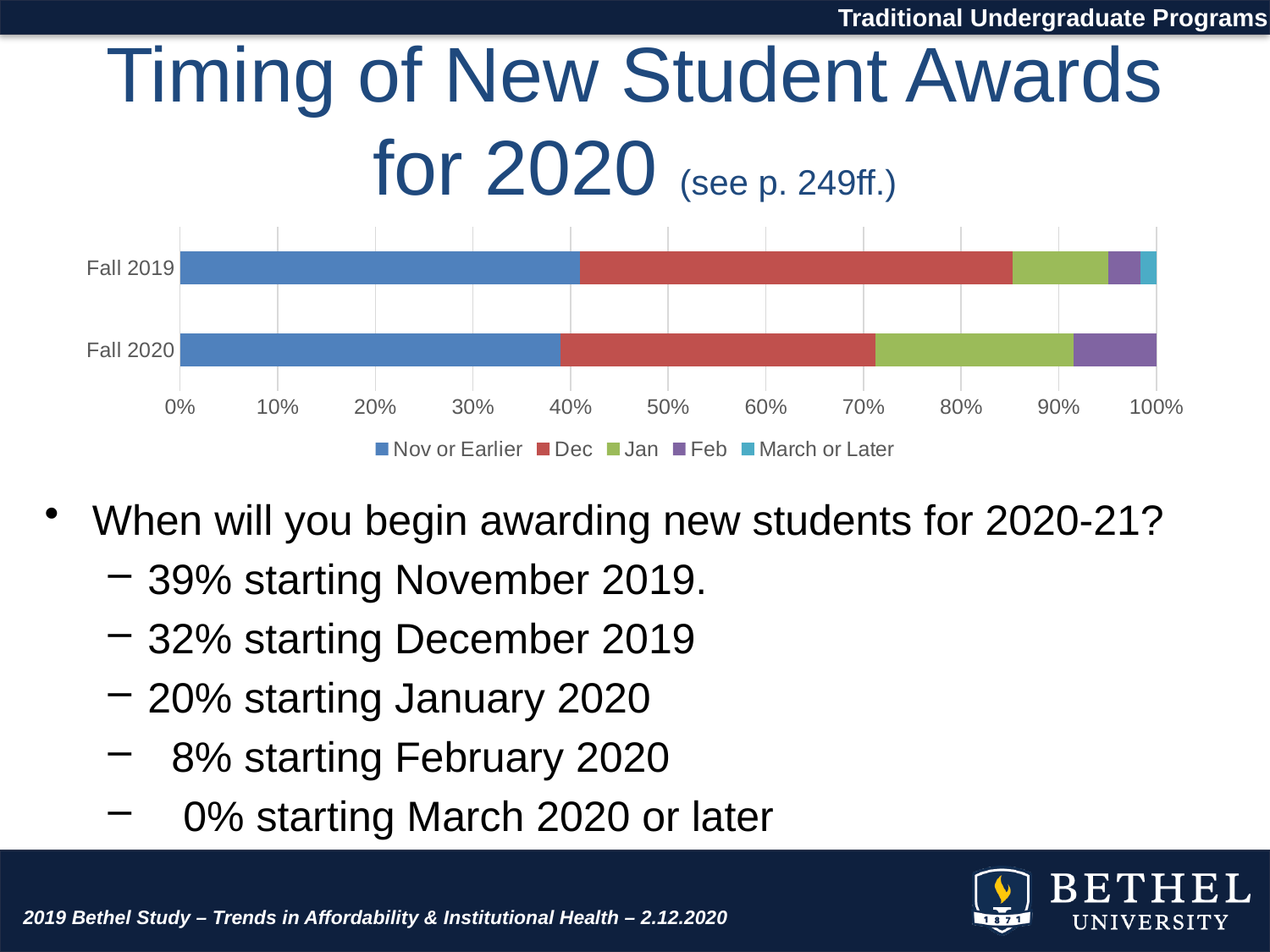
Which bar has the larger 'Jan' segment, Fall 2019 or Fall 2020? Fall 2020 What percentage of the Fall 2020 bar is 'Dec'? 32% What percentage of the Fall 2020 bar is 'March or Later'? 0% How many series does the chart legend list? 5 Which series has the largest segment in the Fall 2020 bar? Nov or Earlier Is the 'Nov or Earlier' segment for Fall 2019 greater or less than 50%? less What percentage of the Fall 2020 bar is 'Jan'? 20% What colour represents 'Dec' in the chart? red Is the 'March or Later' segment for Fall 2019 greater or less than 10%? less What percentage of the Fall 2020 bar is 'Nov or Earlier'? 39% How many categories (bars) does the chart show? 2 What kind of chart is shown on the slide? bar chart